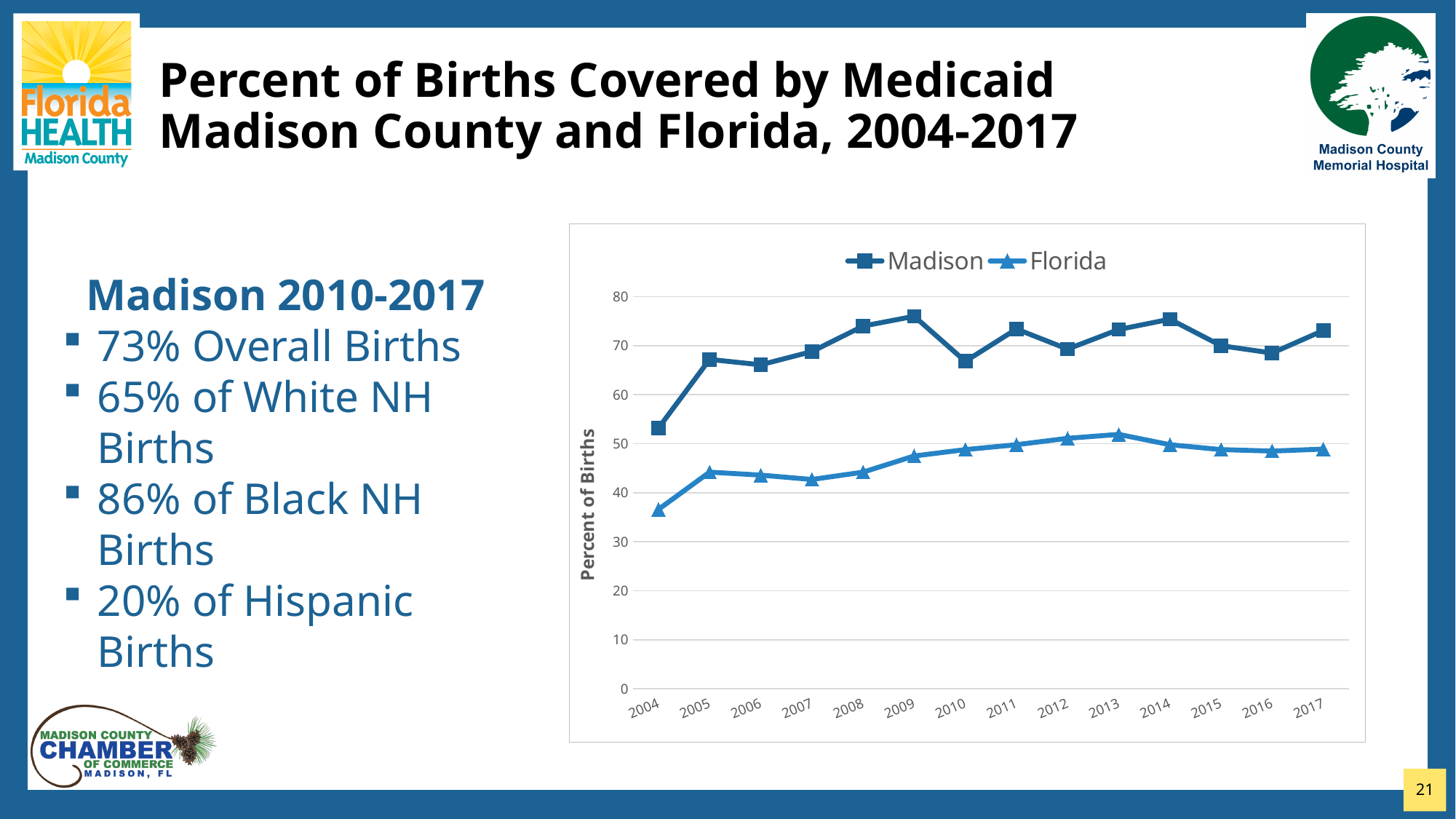
What kind of chart is shown on the slide? line chart Is the value for Madison in 2009 greater or less than 70? greater How many years are plotted along the x axis of the chart? 14 How many series does the chart's legend list? 2 Is the value for Madison in 2004 greater or less than 60? less Is the value for Florida in 2009 greater or less than 50? less What is the label on the chart's vertical axis? Percent of Births In which year is the Florida series at its lowest value? 2004 Does the Florida series rise or fall from 2004 to 2013? rise In 2010, which series has the larger value, Madison or Florida? Madison In which year is the Madison series at its lowest value? 2004